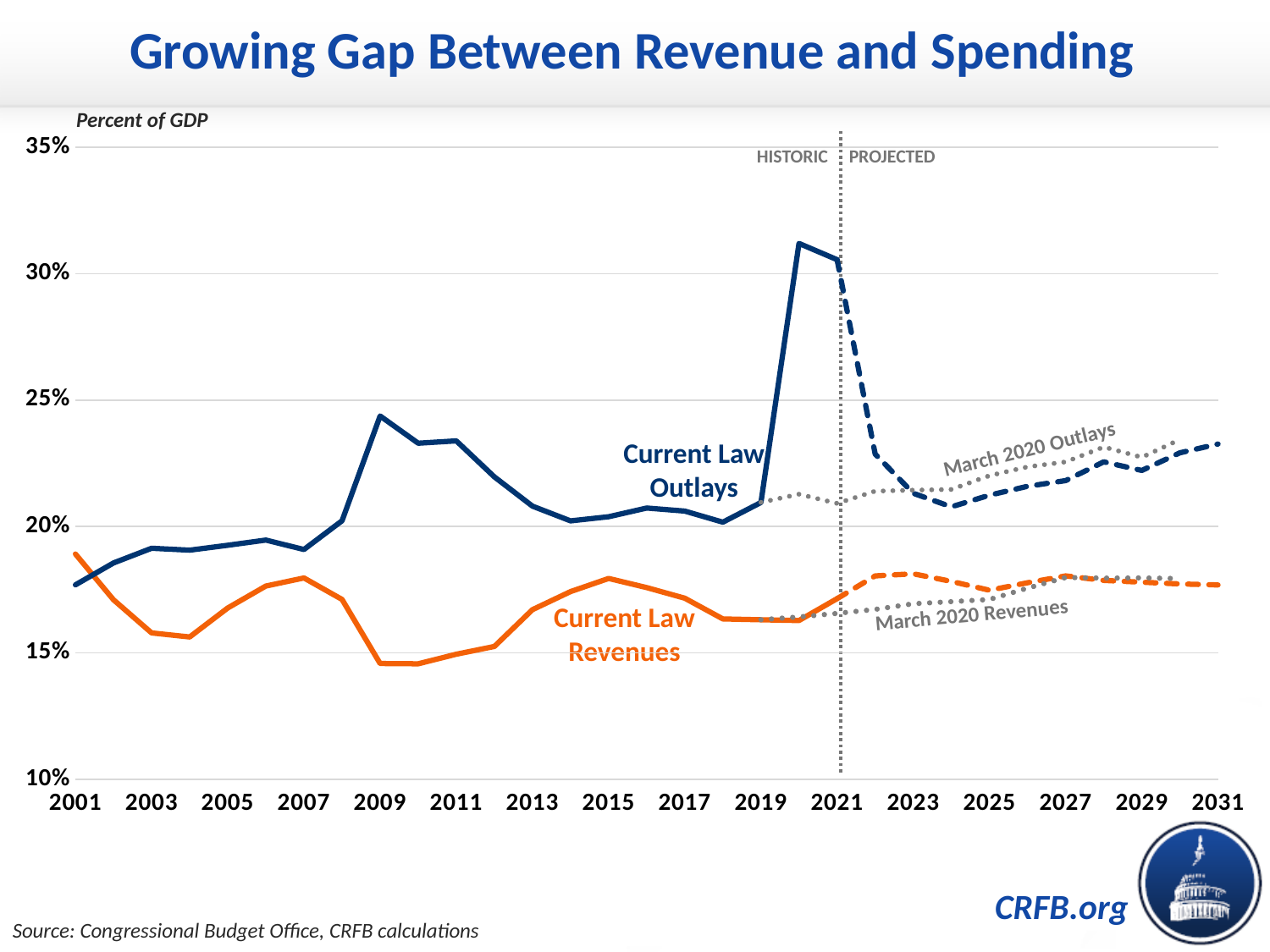
Is the value for Current Law Outlays in 2020 greater or less than 30%? greater What kind of chart is shown on the slide? line chart In which year are Current Law Outlays at their lowest value? 2001 What is the title of the chart? Growing Gap Between Revenue and Spending In 2001, which is higher: Current Law Outlays or Current Law Revenues? Current Law Revenues In which year do Current Law Outlays reach their highest value? 2020 Do Current Law Outlays rise or fall between 2020 and 2024? fall Is the value for Current Law Revenues in 2021 greater or less than 20%? less In 2024, which is higher: March 2020 Outlays or Current Law Outlays? March 2020 Outlays In what unit are the values on the y axis expressed? Percent of GDP Is the value for Current Law Revenues in 2009 greater or less than 15%? less